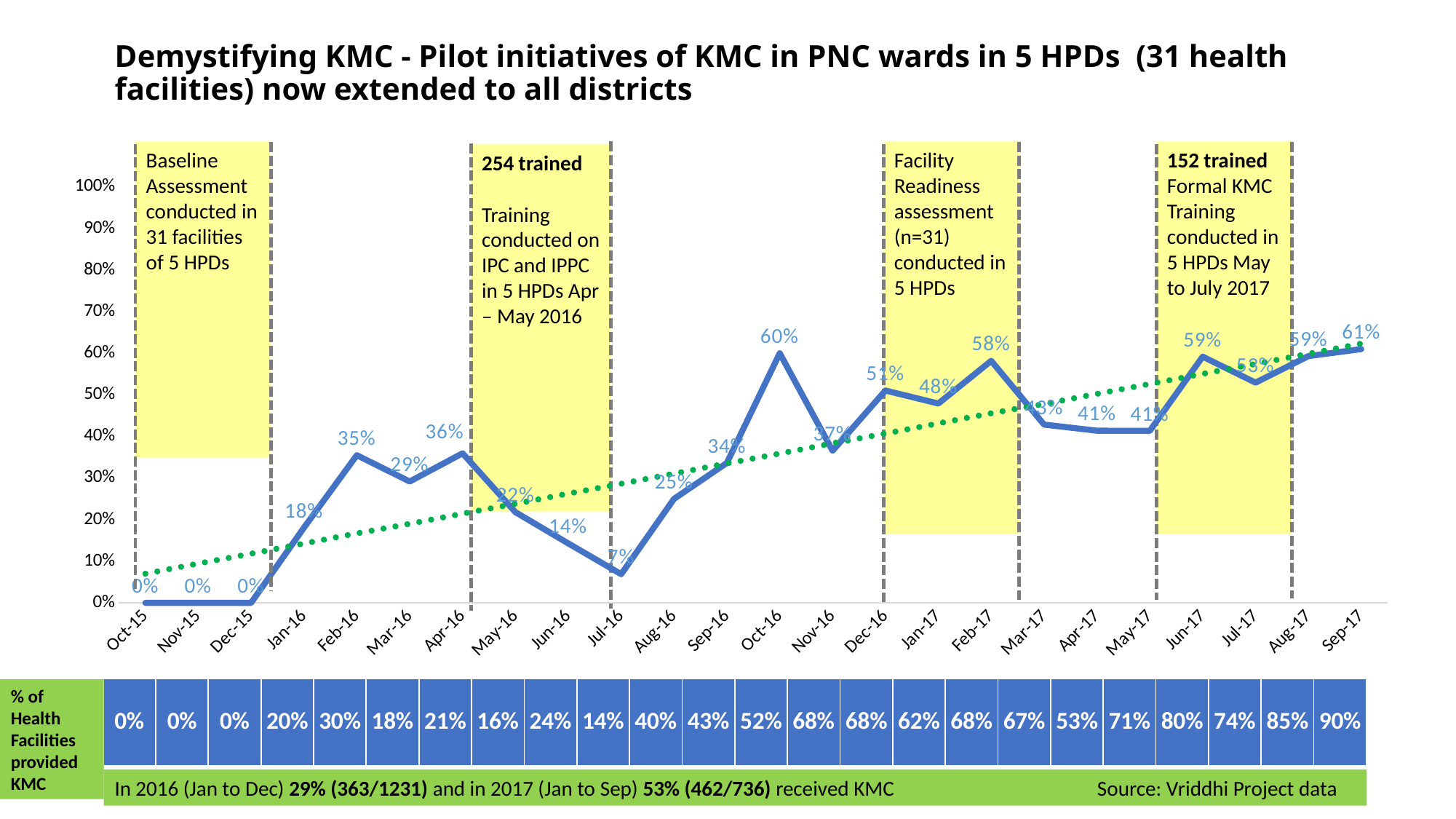
What is the difference between the values for Feb-17 and Jan-17? 10 percentage points What is the value plotted for Sep-16? 34% How many people were trained according to the annotation over the Apr–May 2016 period? 254 trained What is the lowest value plotted on the line chart? 0% Does the plotted line generally rise or fall from Oct-15 to Sep-17? rise What is the value plotted for Oct-16? 60% How many monthly data points are plotted on the line chart? 24 Which is larger, the value for Feb-16 or the value for Apr-16? Apr-16 What is the value plotted for Feb-16? 35% Is the value for Jun-16 greater or less than 20%? less Which month has the highest plotted value on the line chart? Sep-17 What kind of chart is shown on the slide? line chart